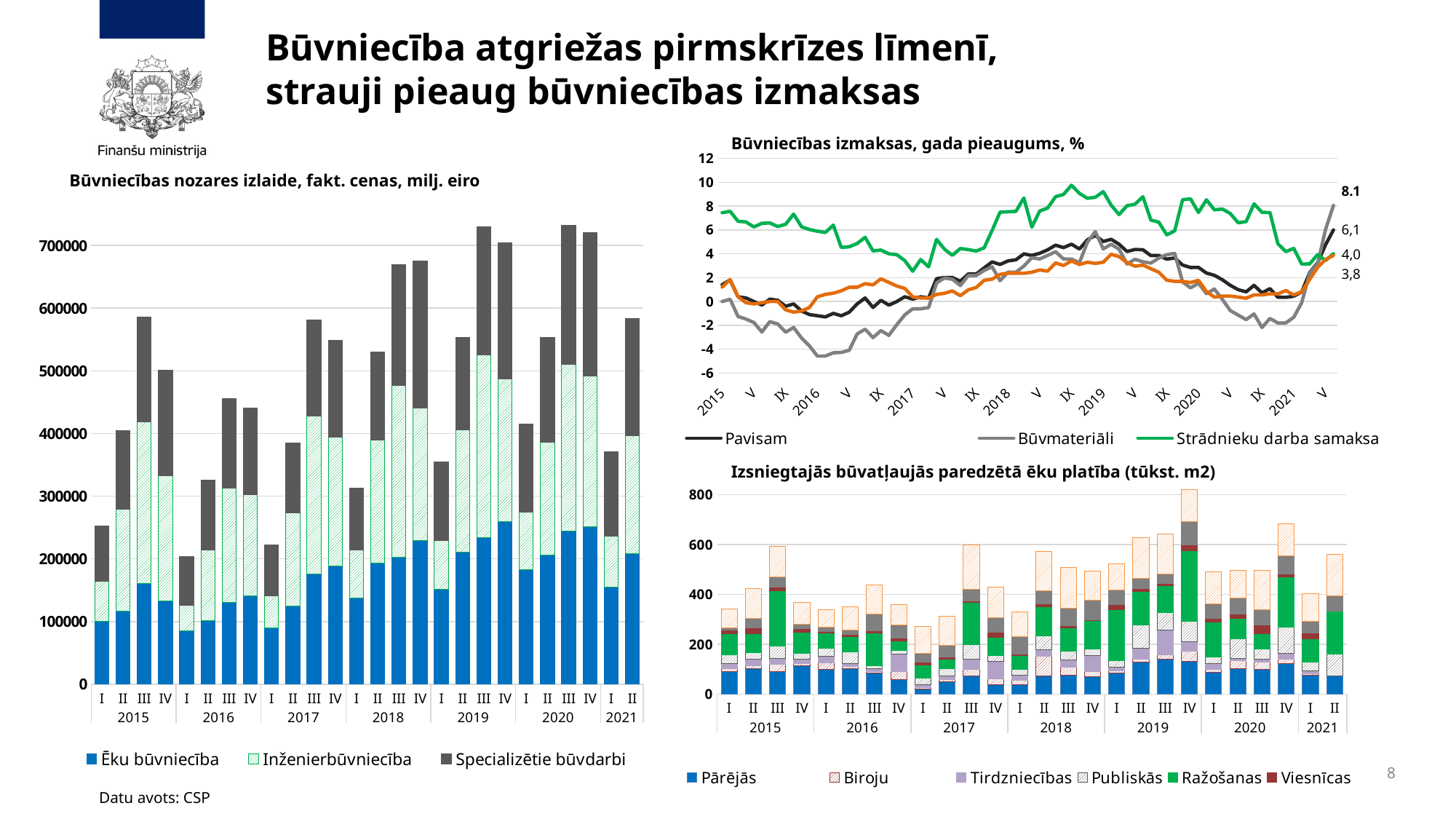
What kind of chart is the top-right chart 'Būvniecības izmaksas, gada pieaugums, %'? line chart How many series does the legend of the bottom-right chart 'Izsniegtajās būvatļaujās paredzētā ēku platība' list? 6 In the top-right chart 'Būvniecības izmaksas, gada pieaugums, %', what is the final labelled value for Būvmateriāli? 8.1 In the left chart 'Būvniecības nozares izlaide', is the total for 2021 II greater or less than 600000? less In the top-right chart 'Būvniecības izmaksas, gada pieaugums, %', what is the final labelled value for Pavisam? 6,1 In the left chart 'Būvniecības nozares izlaide', which total bar is larger: 2017 III or 2018 III? 2018 III What kind of chart is the left chart titled 'Būvniecības nozares izlaide, fakt. cenas, milj. eiro'? bar chart How many series does the legend of the left chart 'Būvniecības nozares izlaide' list? 3 In the left chart 'Būvniecības nozares izlaide', is the total for 2020 III greater or less than 700000? greater In the bottom-right chart 'Izsniegtajās būvatļaujās paredzētā ēku platība', which quarter has the highest total bar? 2019 IV In the bottom-right chart 'Izsniegtajās būvatļaujās paredzētā ēku platība', is the total for 2017 I greater or less than 200? greater In the left chart 'Būvniecības nozares izlaide', which quarter has the lowest total bar? 2016 I